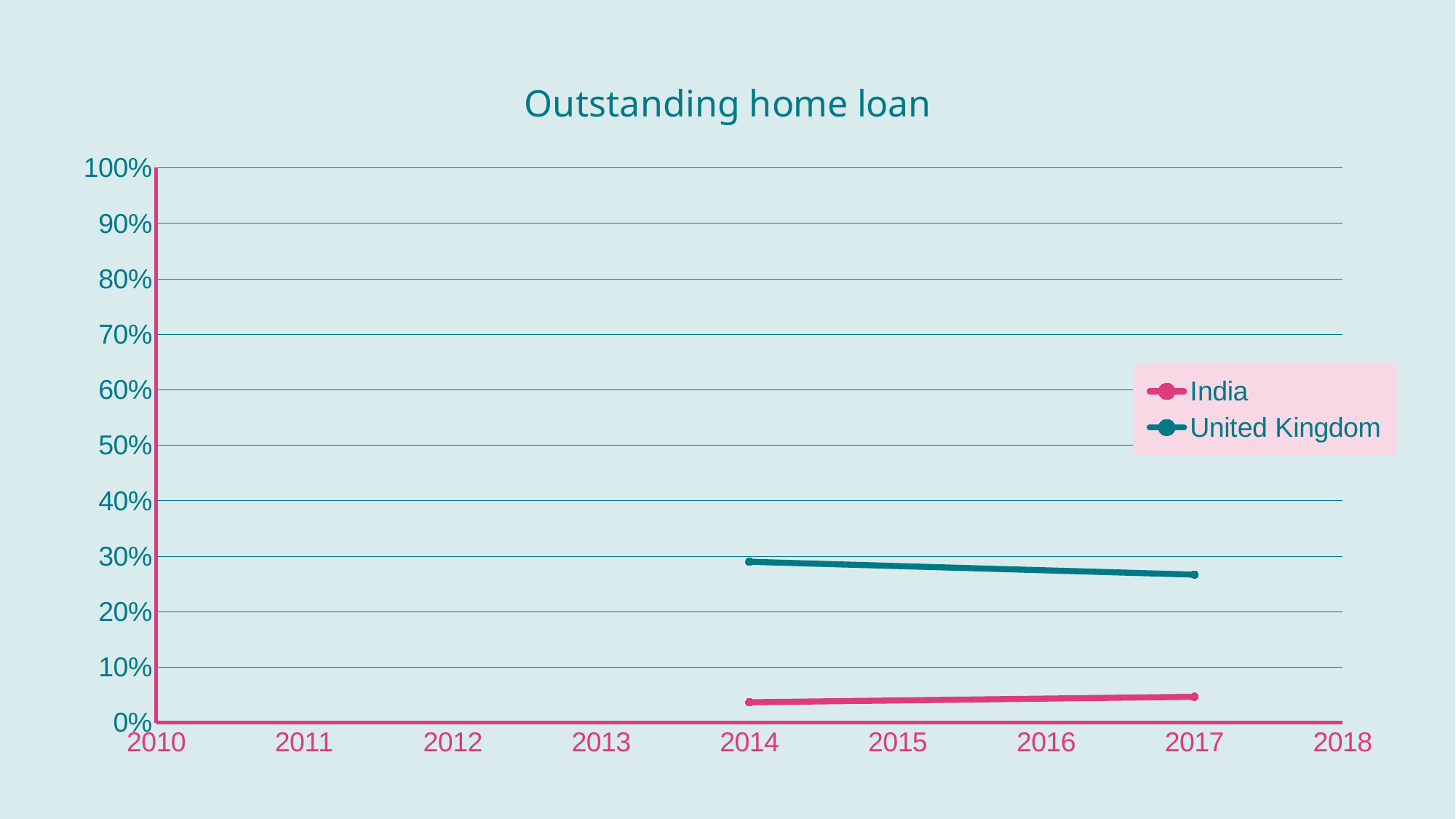
How many data points are plotted for the India series? 2 What kind of chart is shown on the slide? line chart Which series has the higher value in 2017, India or United Kingdom? United Kingdom Is the value for United Kingdom in 2017 greater or less than 30%? less What is the title of the chart? Outstanding home loan Does the United Kingdom line rise or fall from 2014 to 2017? fall How many series does the legend list? 2 Does the India line rise or fall from 2014 to 2017? rise Is the value for United Kingdom in 2014 greater or less than 20%? greater Is the value for India in 2017 greater or less than 10%? less Which series has the lower value in 2014, India or United Kingdom? India Which two series are listed in the legend? India and United Kingdom